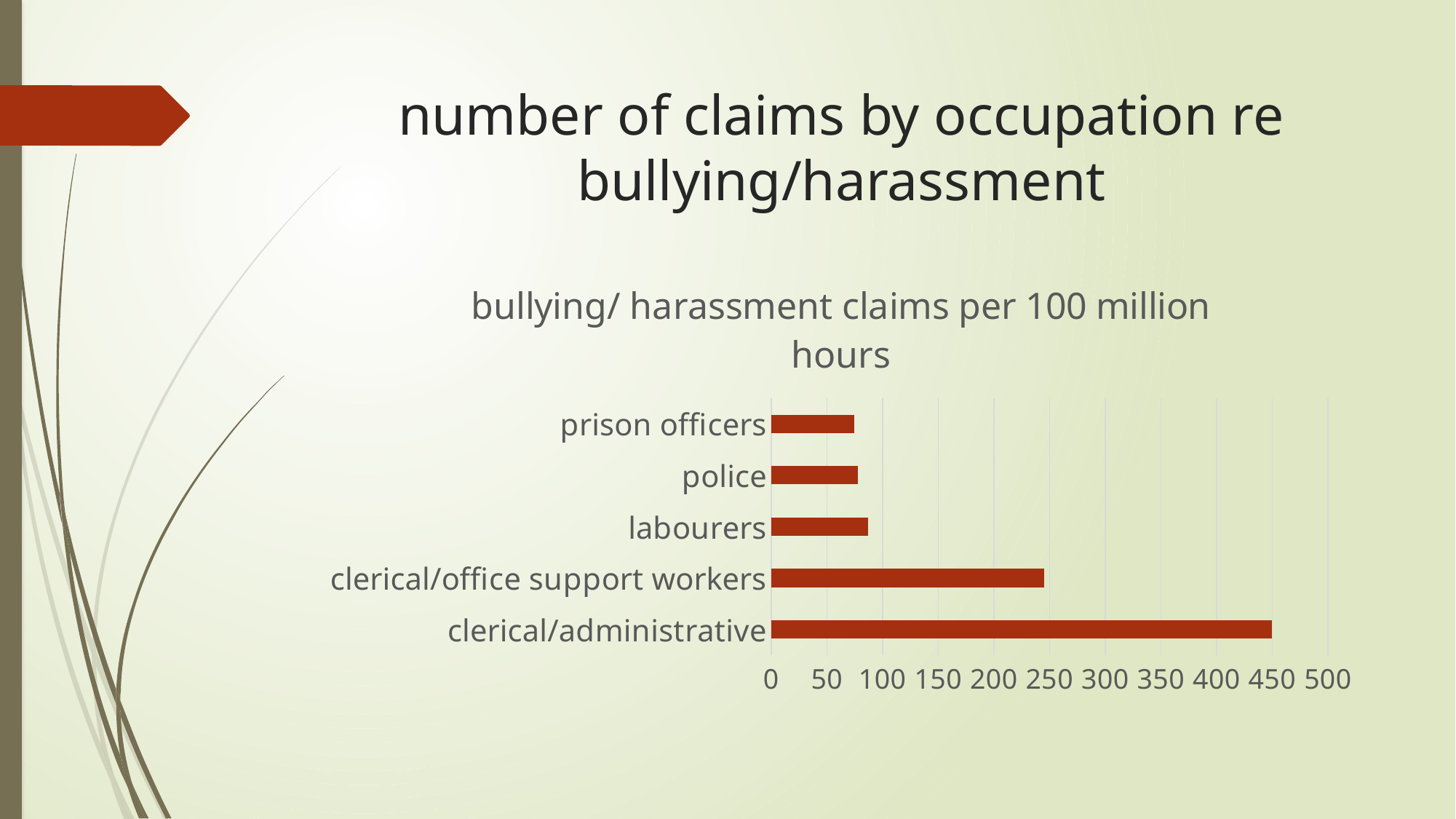
Is the value for labourers greater or less than 100? less Is the value for clerical/administrative greater or less than 400? greater Which occupation has the highest number of bullying/harassment claims per 100 million hours? clerical/administrative Which has more claims per 100 million hours: labourers or clerical/office support workers? clerical/office support workers What is the title of the chart? bullying/ harassment claims per 100 million hours What kind of chart is shown on the slide? bar chart Is the value for prison officers greater or less than 50? greater What is the maximum value shown on the horizontal axis? 500 How many occupations are plotted in the chart? 5 Which has more claims per 100 million hours: clerical/administrative or clerical/office support workers? clerical/administrative